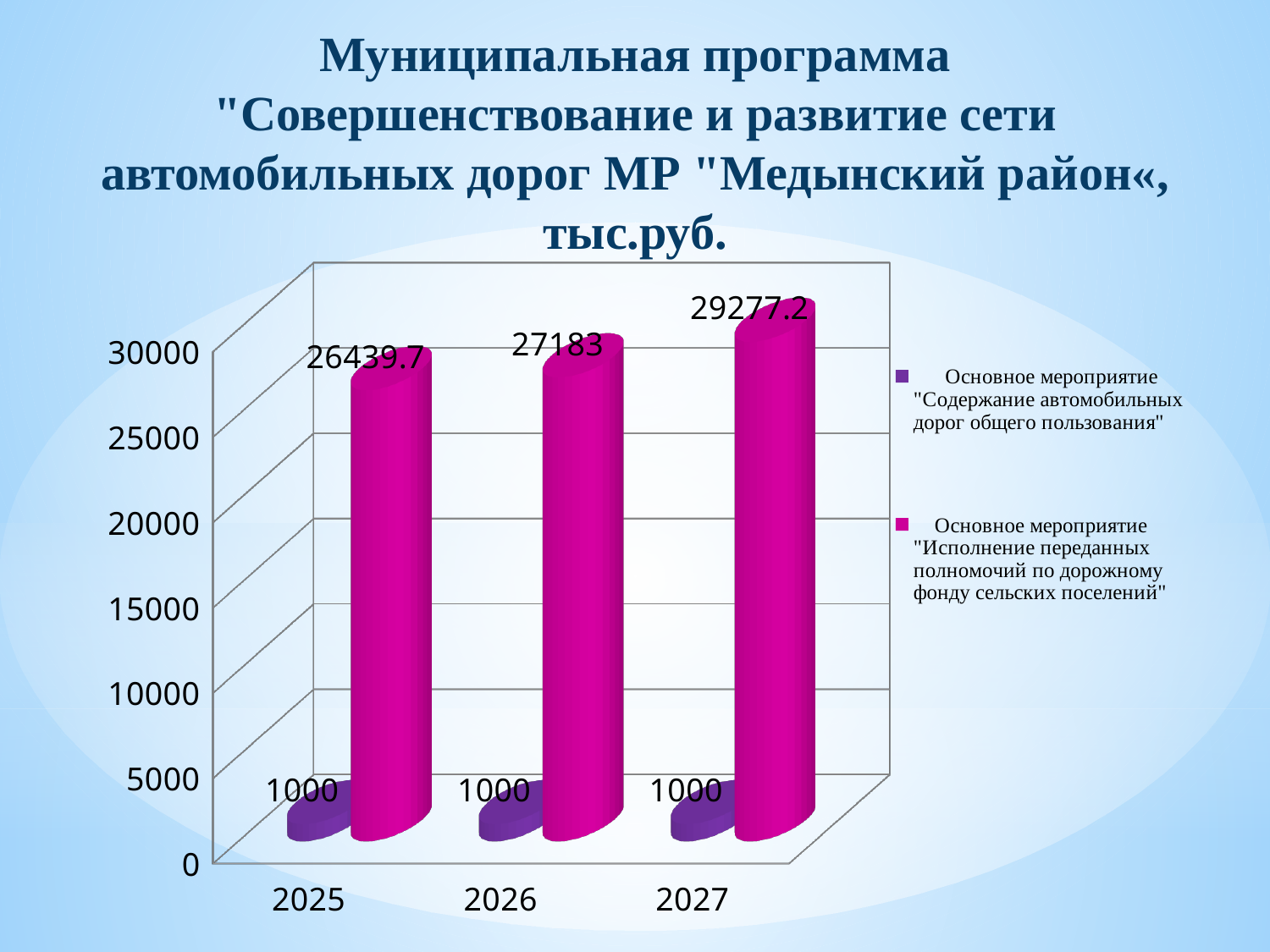
What is the value for 2027 for the series "Исполнение переданных полномочий по дорожному фонду сельских поселений"? 29277.2 How many series does the legend list? 2 In which year is the value for "Исполнение переданных полномочий по дорожному фонду сельских поселений" the lowest? 2025 How many years are shown on the x axis? 3 Do the values for "Исполнение переданных полномочий по дорожному фонду сельских поселений" rise or fall from 2025 to 2027? Rise What kind of chart is shown on the slide? Bar chart What is the difference between the 2027 and 2025 values for "Исполнение переданных полномочий по дорожному фонду сельских поселений"? 2837.5 In which year is the value for "Исполнение переданных полномочий по дорожному фонду сельских поселений" the highest? 2027 Which is larger for 2026: the value for "Содержание автомобильных дорог общего пользования" or for "Исполнение переданных полномочий по дорожному фонду сельских поселений"? Исполнение переданных полномочий по дорожному фонду сельских поселений What is the value for 2026 for the series "Исполнение переданных полномочий по дорожному фонду сельских поселений"? 27183 What is the value for 2025 for the series "Исполнение переданных полномочий по дорожному фонду сельских поселений"? 26439.7 What is the value for 2026 for the series "Содержание автомобильных дорог общего пользования"? 1000